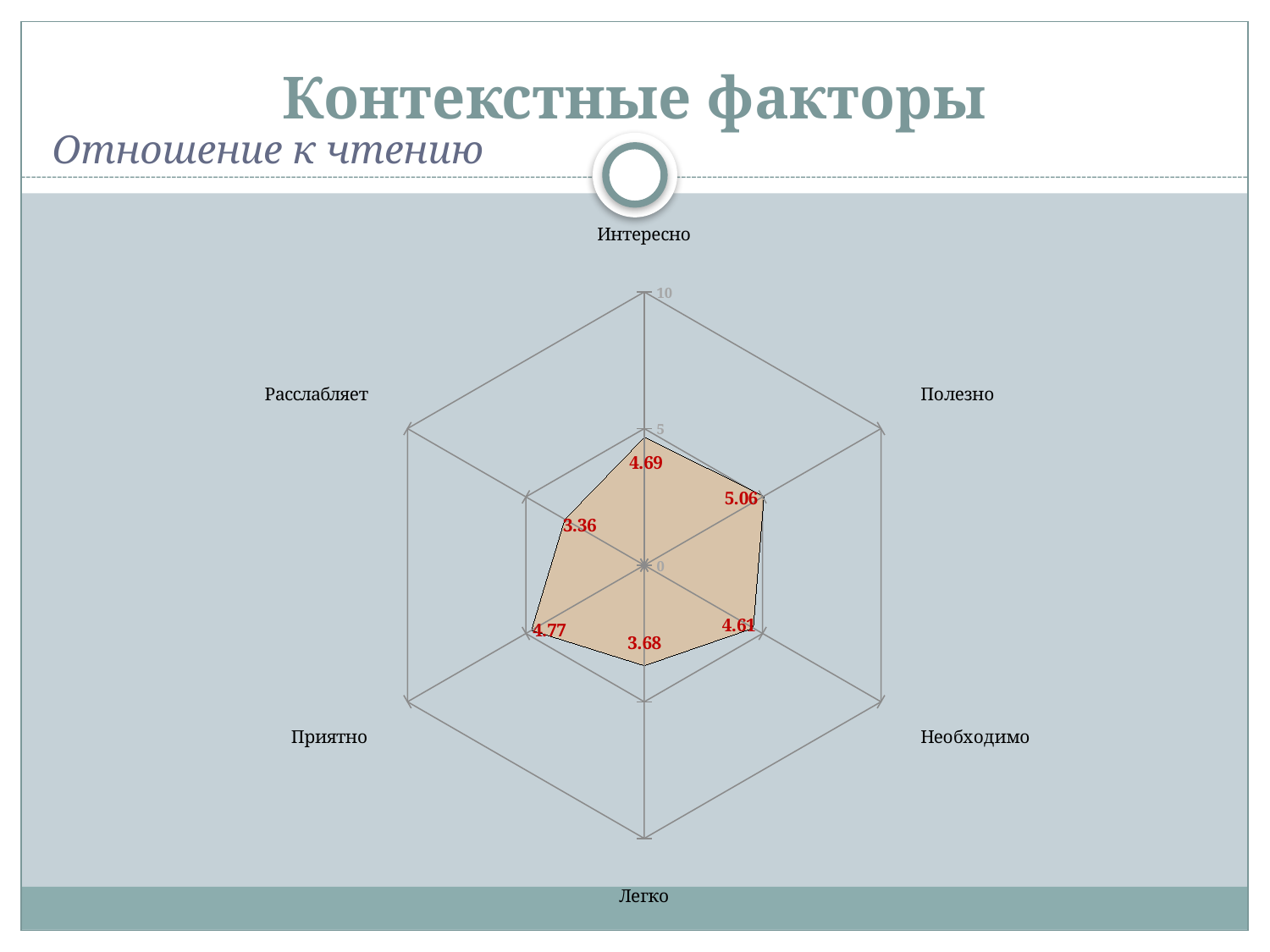
What is the value for Необходимо? 4.61 Which category has the lowest value? Расслабляет What kind of chart is shown on the slide? Radar chart What is the value for Интересно? 4.69 What is the value for Расслабляет? 3.36 What is the value for Легко? 3.68 Which category has the highest value? Полезно How many categories (axes) does the radar chart have? 6 What is the value for Приятно? 4.77 Which is larger, the value for Приятно or the value for Легко? Приятно What is the value for Полезно? 5.06 What is the difference between the values for Полезно and Расслабляет? 1.70